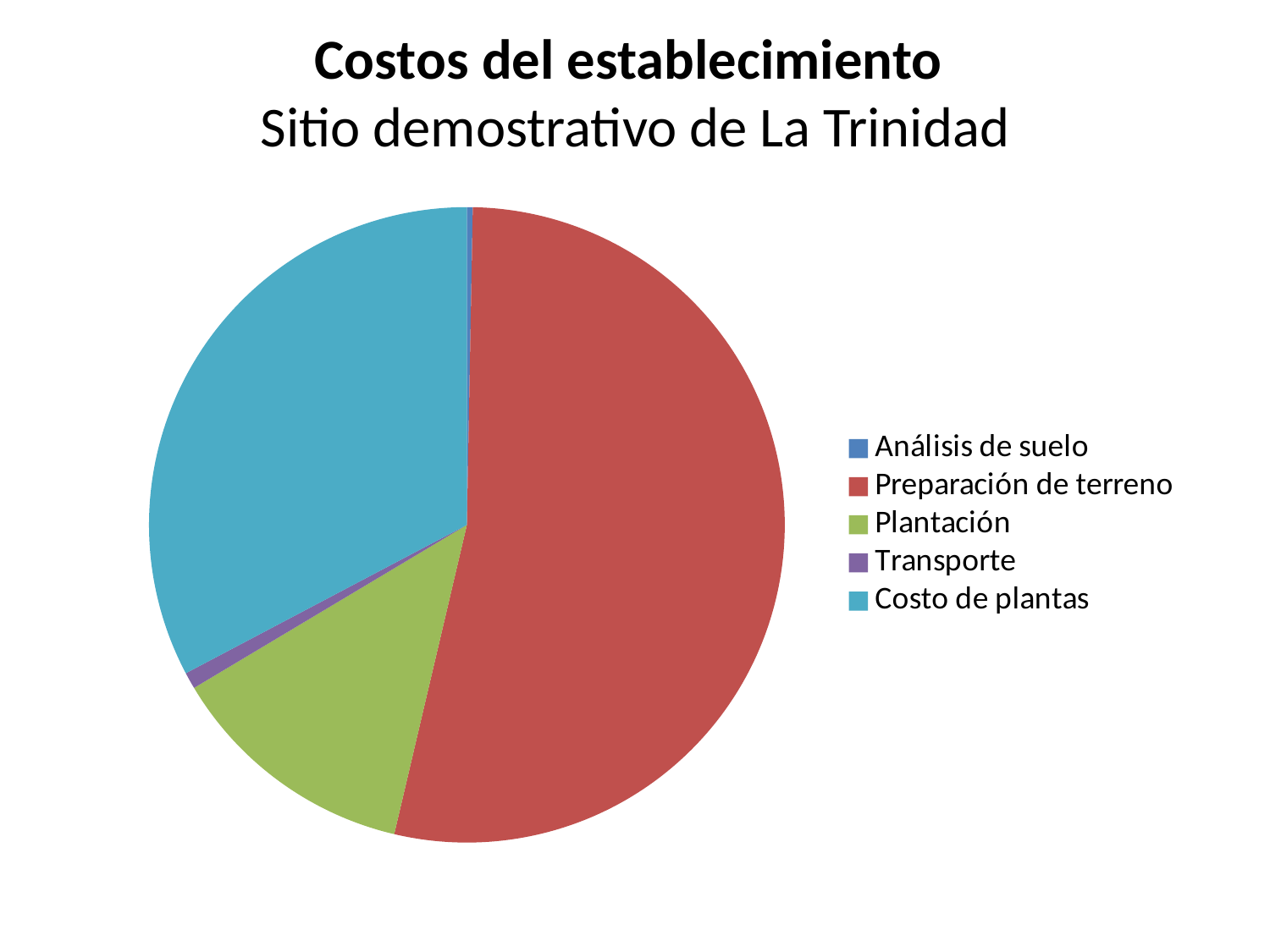
Which category has the largest slice of the pie? Preparación de terreno Which is larger, the slice for Preparación de terreno or the slice for Costo de plantas? Preparación de terreno How many categories does the pie chart show? 5 Which is larger, the slice for Plantación or the slice for Transporte? Plantación What is the title of the chart? Costos del establecimiento Sitio demostrativo de La Trinidad Is the slice for Preparación de terreno more or less than half of the pie? more Which colour represents Preparación de terreno in the pie chart? Red What kind of chart is shown on the slide? Pie chart Which is larger, the slice for Costo de plantas or the slice for Plantación? Costo de plantas